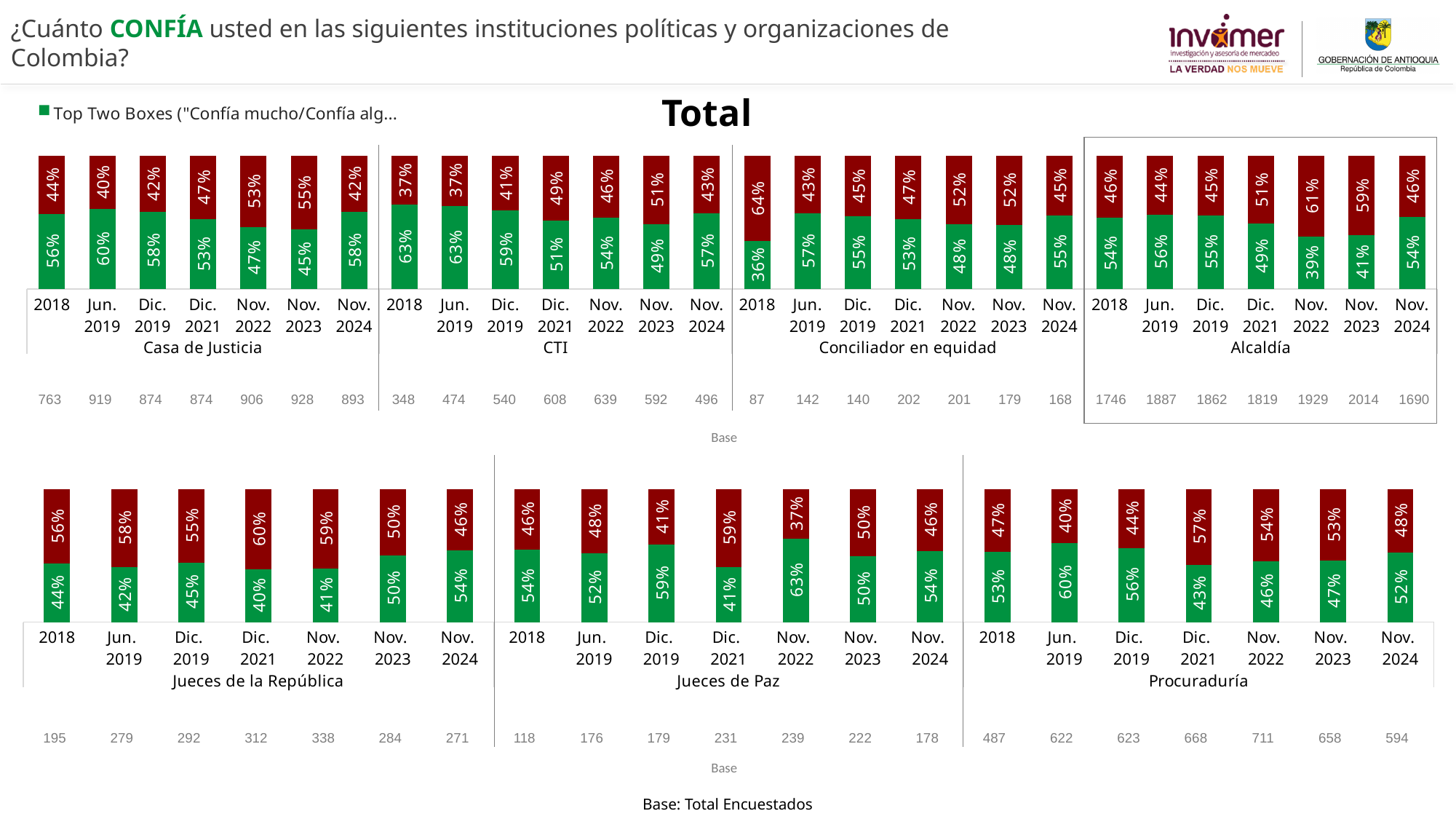
In the bottom chart, which period has the highest Top Two Boxes (green) value for Procuraduría? Jun. 2019 In the top chart, what is the base (number of respondents) for Alcaldía in Nov. 2023? 2014 In the bottom chart, do the Top Two Boxes (green) values for Jueces de la República rise or fall from Dic. 2021 to Nov. 2024? Rise In the bottom chart, what is the Top Two Boxes (green) value for Jueces de Paz in Nov. 2022? 63% What is the legend entry shown for the green series? Top Two Boxes ("Confía mucho/Confía alg... What kind of chart is used on this slide? Stacked bar chart In the top chart, what is the Top Two Boxes (green) value for Alcaldía in Nov. 2022? 39% In the top chart, what is the difference between the Top Two Boxes (green) values for Casa de Justicia in 2018 and Nov. 2023? 11 percentage points How many institutions are shown in the top chart? 4 In the top chart, which period has the lowest Top Two Boxes (green) value for Alcaldía? Nov. 2022 In the bottom chart, which has the larger Top Two Boxes (green) value in 2018: Jueces de la República or Jueces de Paz? Jueces de Paz In the top chart, what is the total of the stacked bar for Conciliador en equidad in 2018? 100%